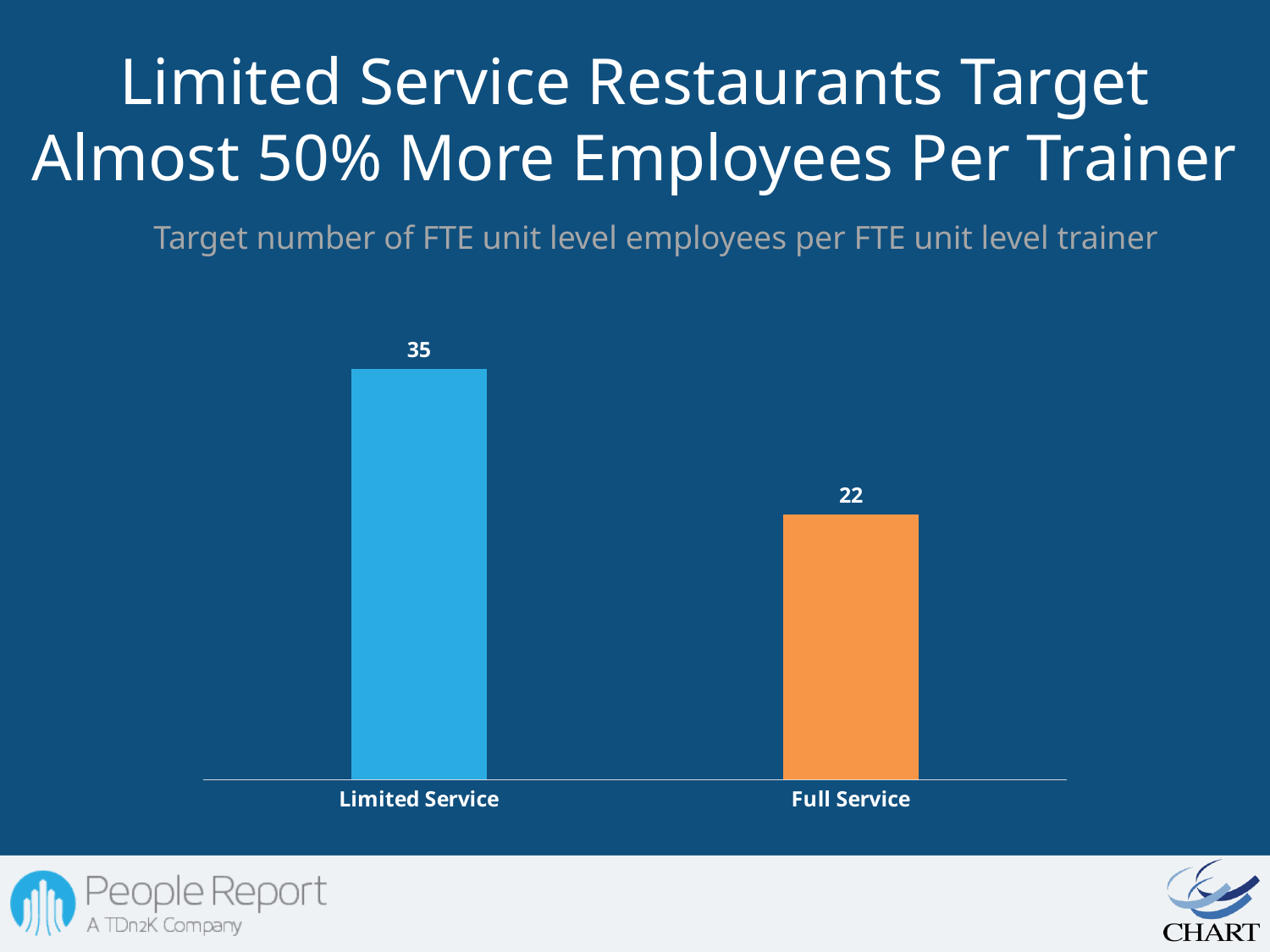
What kind of chart is shown on the slide? Bar chart What colour is the Full Service bar? Orange Which category has the lowest target number of employees per trainer? Full Service What is the difference between the Limited Service and Full Service values? 13 What is the target number of FTE unit level employees per FTE unit level trainer for Limited Service? 35 What is the subtitle describing what the chart measures? Target number of FTE unit level employees per FTE unit level trainer Which is larger, the value for Limited Service or the value for Full Service? Limited Service How many categories are shown in the chart? 2 Which category has the highest target number of employees per trainer? Limited Service What is the target number of FTE unit level employees per FTE unit level trainer for Full Service? 22